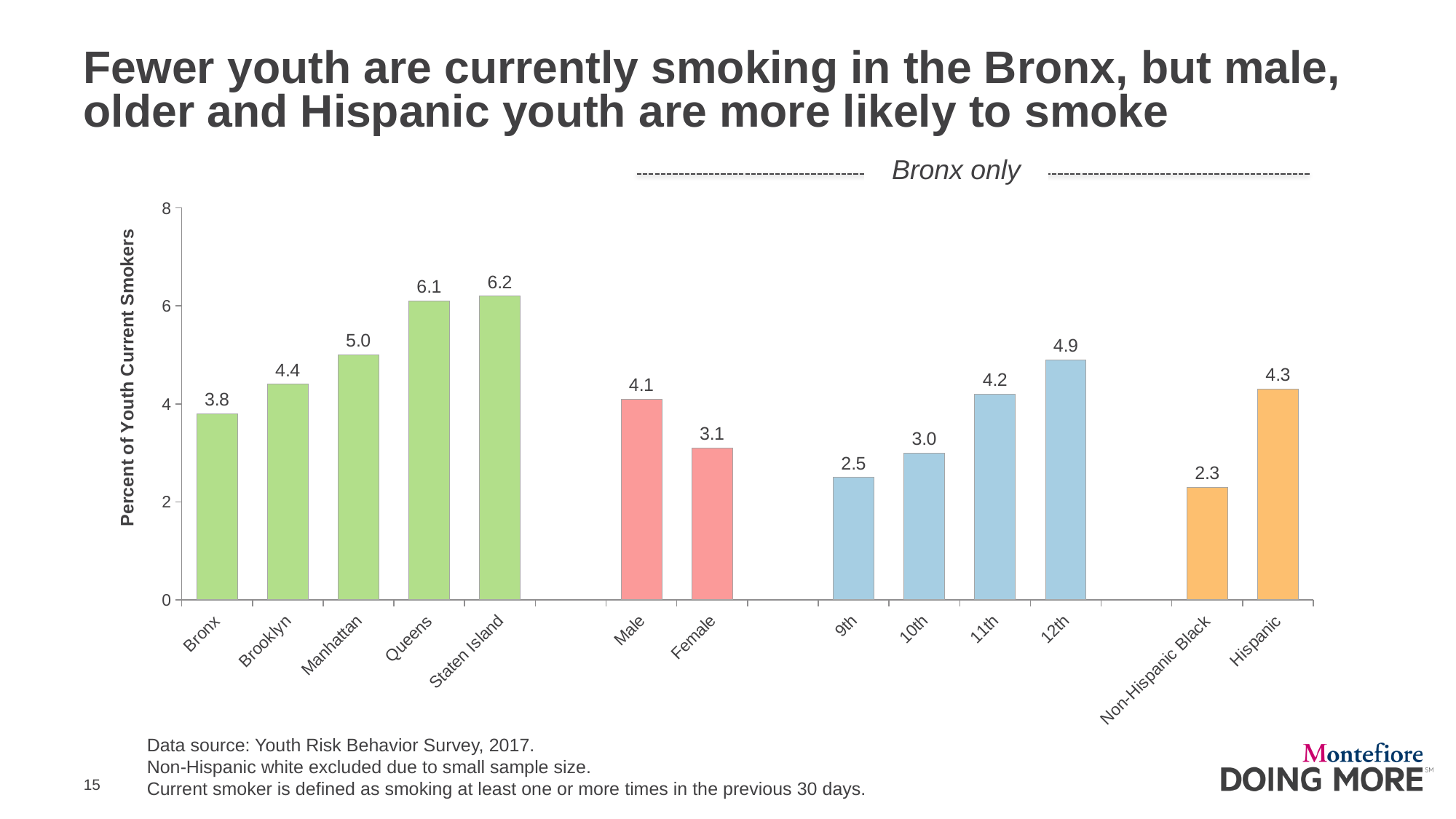
How many bars are plotted on the chart? 13 What is the difference between the values for Hispanic and Non-Hispanic Black? 2.0 What kind of chart is shown on the slide? Bar chart What is the value for Female? 3.1 What is the value for 12th grade? 4.9 What is the value for Bronx? 3.8 What is the difference between the values for Male and Female? 1.0 Which category has the lowest value on the chart? Non-Hispanic Black Which category has the highest value on the chart? Staten Island Which is larger, the value for Queens or the value for Manhattan? Queens Do the values rise or fall from 9th grade to 12th grade? Rise What is the value for Staten Island? 6.2